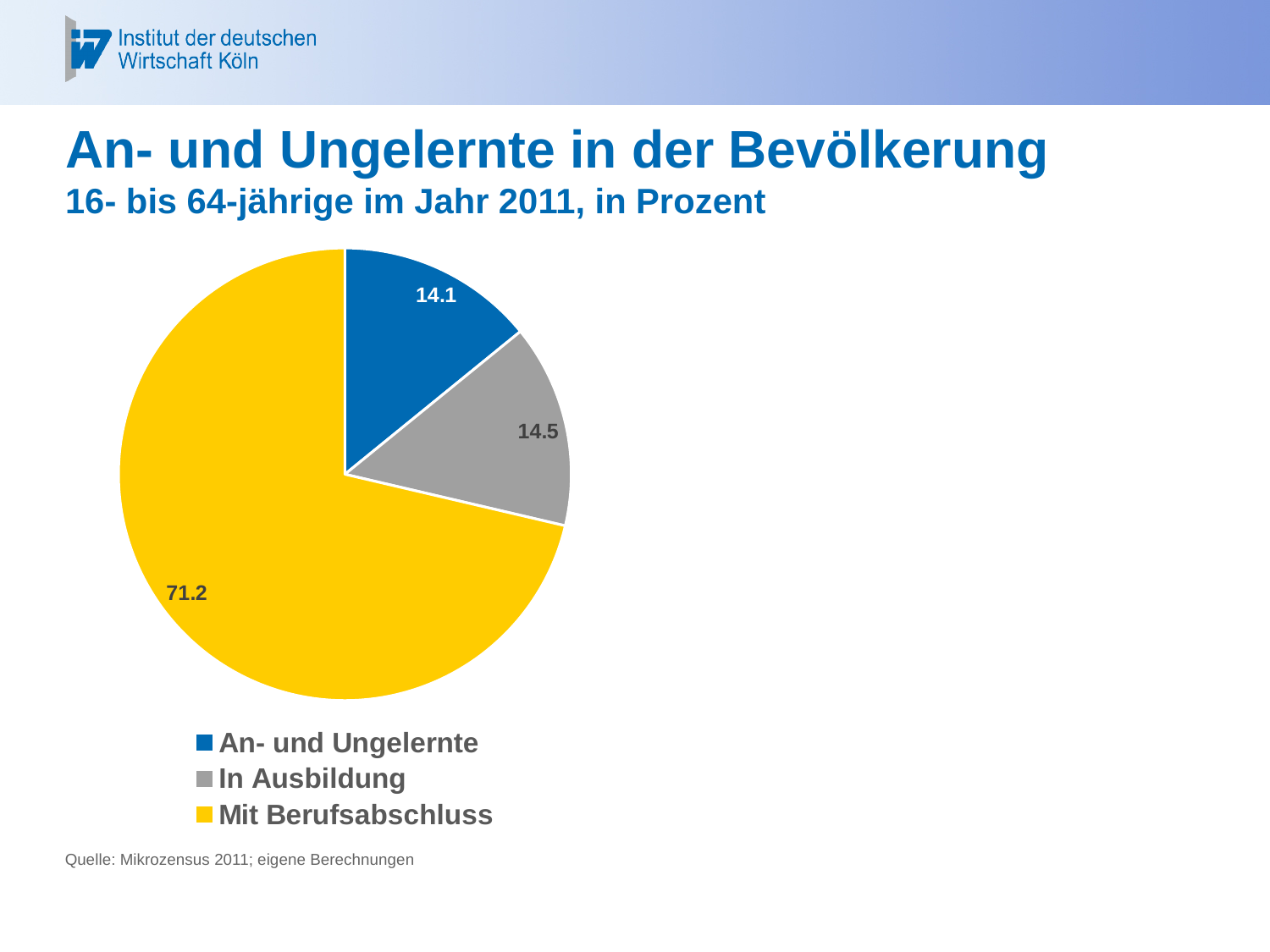
Which colour represents "An- und Ungelernte" in the pie chart? blue How many slices does the pie chart have? 3 Which category has the largest slice of the pie? Mit Berufsabschluss What is the value for "Mit Berufsabschluss"? 71.2 Is the value for "Mit Berufsabschluss" larger than the value for "An- und Ungelernte"? yes What kind of chart is shown on the slide? pie chart How many entries does the legend list? 3 What is the difference between the values for "In Ausbildung" and "An- und Ungelernte"? 0.4 What is the value for "An- und Ungelernte"? 14.1 Which colour represents "Mit Berufsabschluss" in the pie chart? yellow What is the value for "In Ausbildung"? 14.5 What is the difference between the values for "Mit Berufsabschluss" and "In Ausbildung"? 56.7